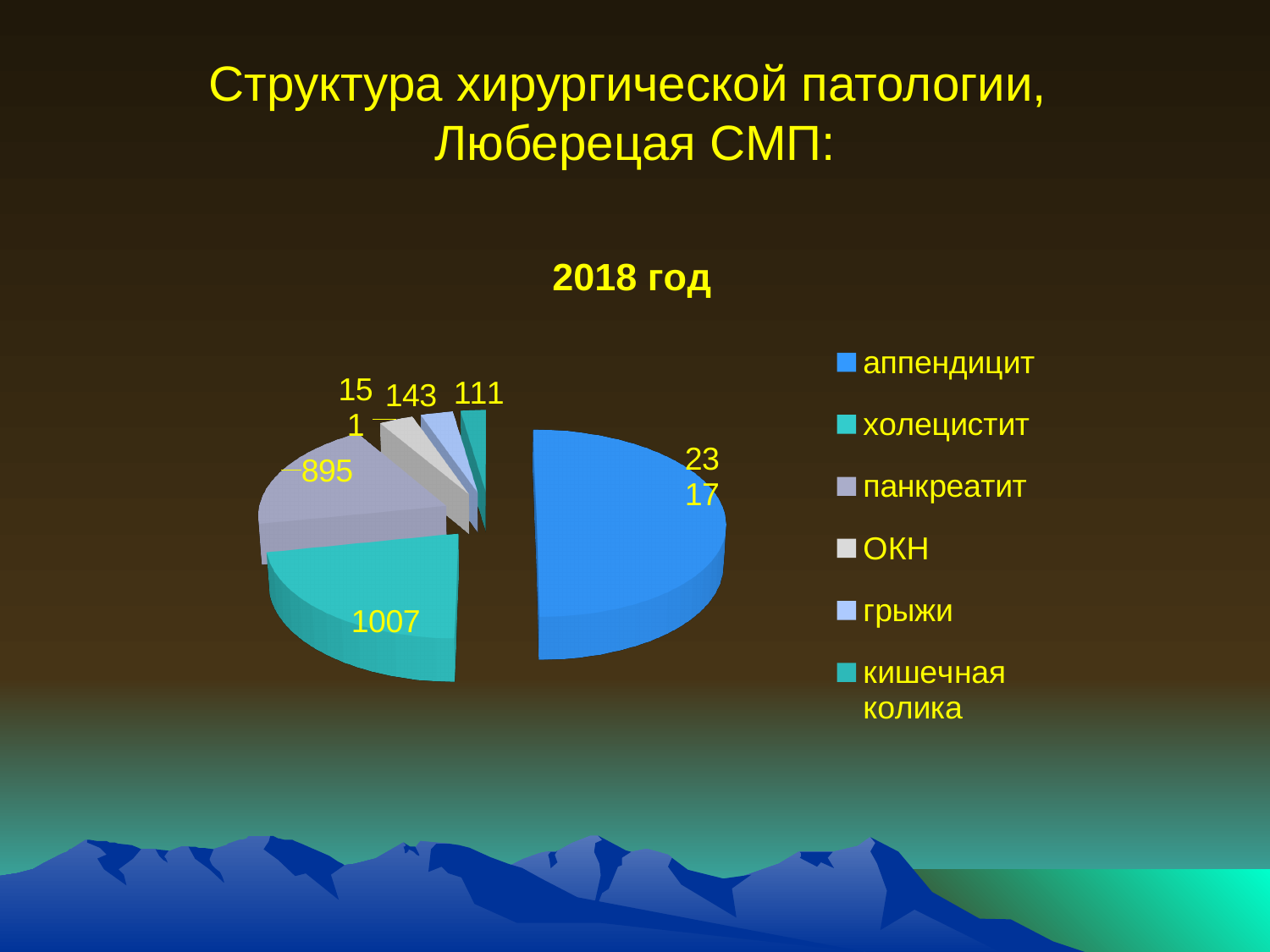
What is the title of the chart? 2018 год What is the value for панкреатит? 895 What is the value for холецистит? 1007 What is the difference between the values for холецистит and панкреатит? 112 What is the value for грыжи? 143 What is the value for кишечная колика? 111 Which category has the smallest slice? кишечная колика Which category has the largest slice? аппендицит What is the value for аппендицит? 2317 What type of chart is shown on the slide? pie chart How many categories does the legend list? 6 Which is larger, the value for грыжи or the value for кишечная колика? грыжи